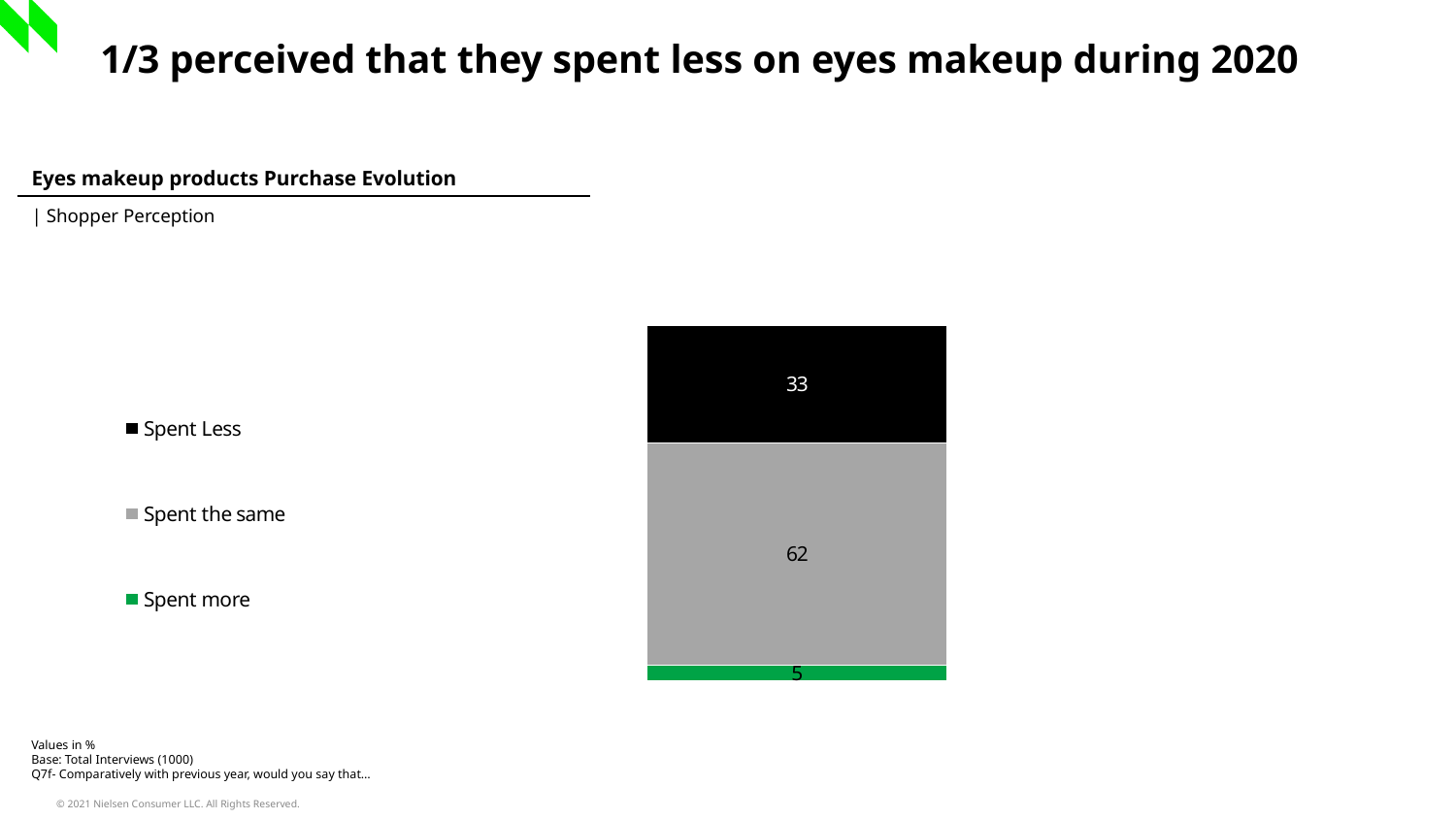
What colour represents the Spent more segment? Green Which segment has the lowest value? Spent more What value is shown for the Spent Less segment? 33 What kind of chart is shown on the slide? Stacked bar chart What is the difference between the Spent the same and Spent Less values? 29 What value is shown for the Spent the same segment? 62 How many series does the legend list? 3 What is the title of the chart? Eyes makeup products Purchase Evolution Which is larger, the value for Spent Less or the value for Spent more? Spent Less What value is shown for the Spent more segment? 5 Which segment has the highest value? Spent the same What is the total of the stacked bar? 100